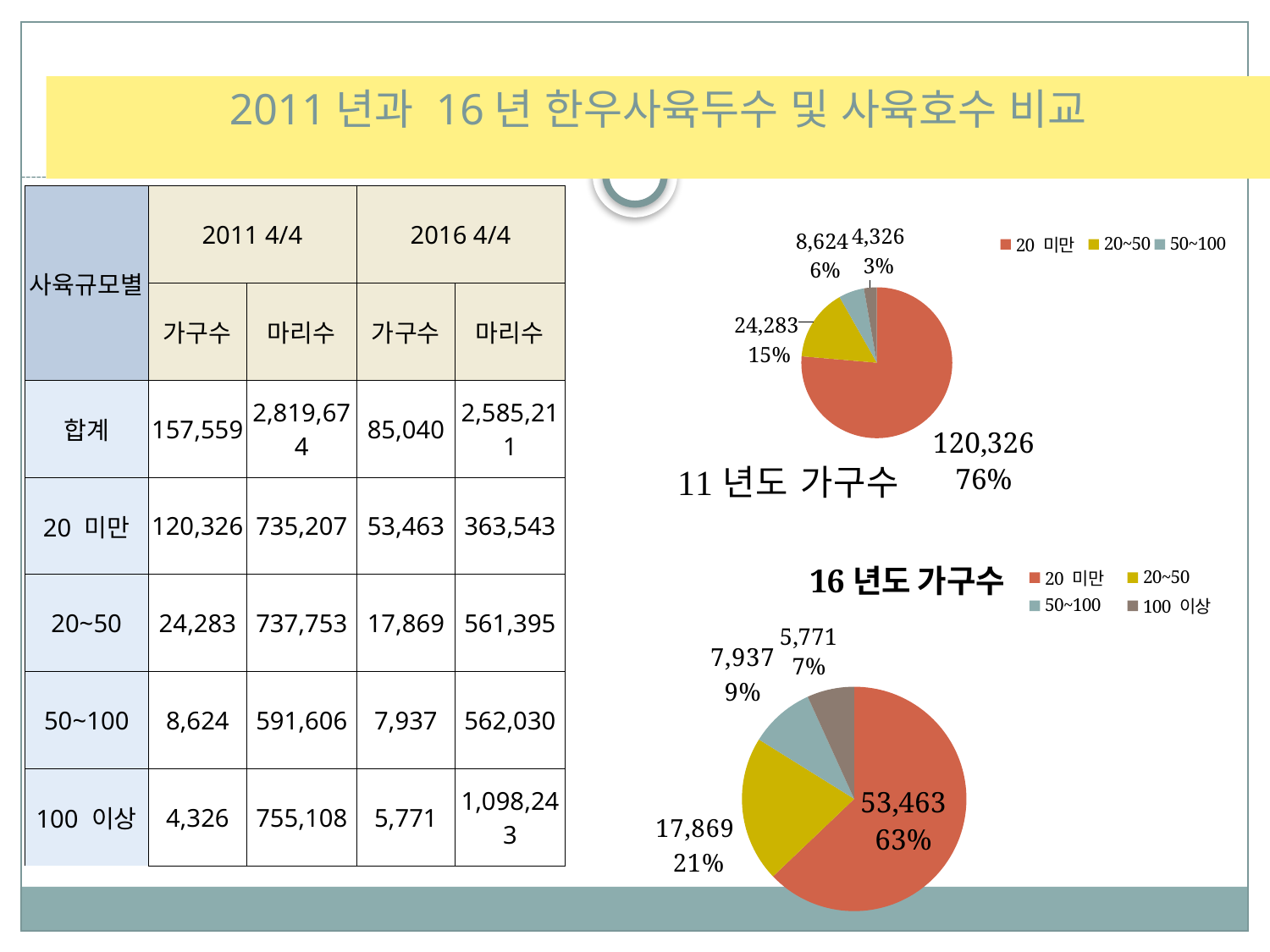
In the "11 년도 가구수" pie chart, which category has the smallest slice? 100 이상 (4,326) In the "16 년도 가구수" pie chart, which is larger, the 50~100 slice or the 100 이상 slice? 50~100 In the "11 년도 가구수" pie chart, what percentage share does the 20~50 slice have? 15% In the "11 년도 가구수" pie chart, what value is shown for the 20 미만 slice? 120,326 In the "16 년도 가구수" pie chart, what value is shown for the 20~50 slice? 17,869 What type of chart is used for "11 년도 가구수"? Pie chart How many entries does the legend of the "16 년도 가구수" chart list? 4 In the "16 년도 가구수" pie chart, what percentage share does the 20 미만 slice have? 63% In the "16 년도 가구수" pie chart, which category has the largest slice? 20 미만 In the "11 년도 가구수" pie chart, what is the difference between the 20~50 value and the 50~100 value? 15,659 In the "16 년도 가구수" pie chart, what is the difference between the 50~100 value and the 100 이상 value? 2,166 How many slices does the "16 년도 가구수" pie chart have? 4